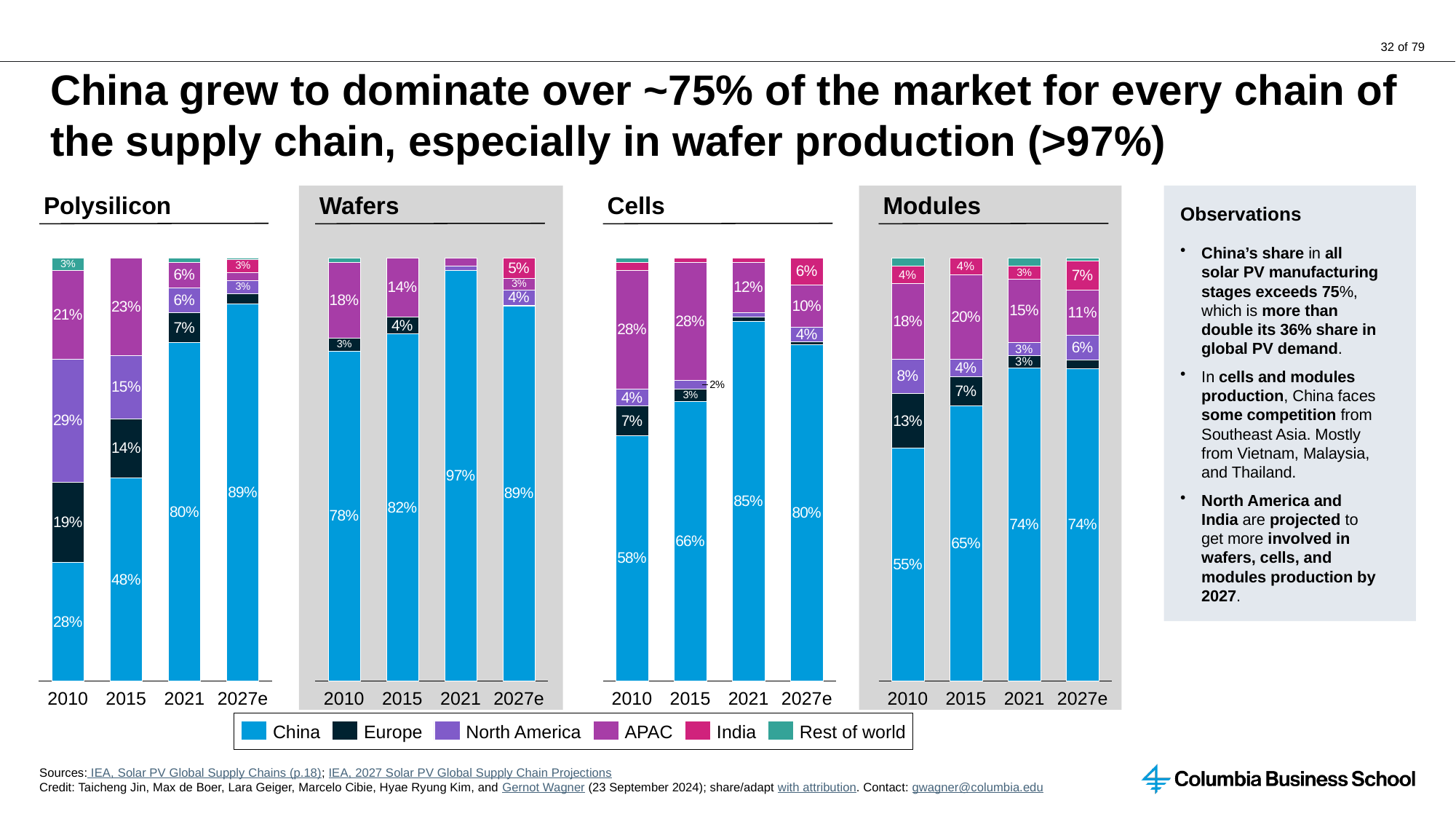
How many years are shown on the x axis of the Cells chart? 4 What kind of chart is the Modules chart? Stacked bar chart In the Polysilicon chart, does China's share rise or fall from 2010 to 2027e? Rise In the Cells chart, what is the difference between China's share in 2021 and in 2010? 27% How many series does the legend list? 6 In the Cells chart, what is APAC's share in 2015? 28% In the Wafers chart, is APAC's share larger in 2010 or in 2015? 2010 In the Polysilicon chart, what is North America's share in 2010? 29% In the Modules chart, what is Europe's share in 2010? 13% In the Wafers chart, what is China's share in 2021? 97% In the Polysilicon chart, which year has the highest China share? 2027e In the Modules chart, which year has the lowest China share? 2010